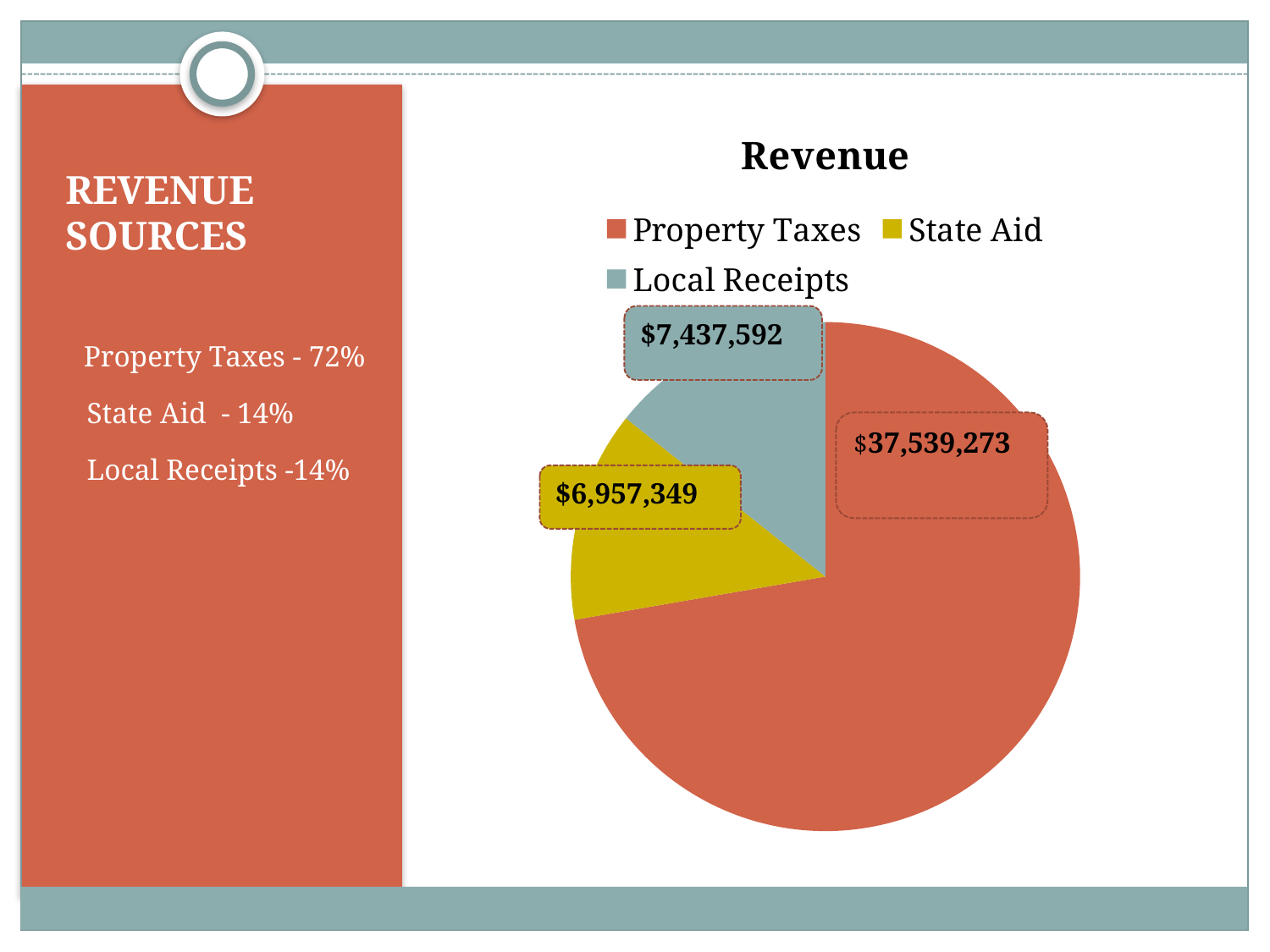
Which category has the largest slice in the Revenue pie chart? Property Taxes What is the value for Property Taxes in the Revenue pie chart? $37,539,273 What is the difference between the Property Taxes value and the State Aid value? $30,581,924 Which category has the smallest slice in the Revenue pie chart? State Aid What is the value for State Aid in the Revenue pie chart? $6,957,349 What type of chart is shown on the slide? pie chart How many categories are shown in the Revenue pie chart? 3 Which is larger in the Revenue pie chart, Local Receipts or State Aid? Local Receipts What is the difference between the Local Receipts value and the State Aid value? $480,243 What is the value for Local Receipts in the Revenue pie chart? $7,437,592 What is the title of the chart? Revenue What share of total revenue do Property Taxes represent, according to the slide? 72%